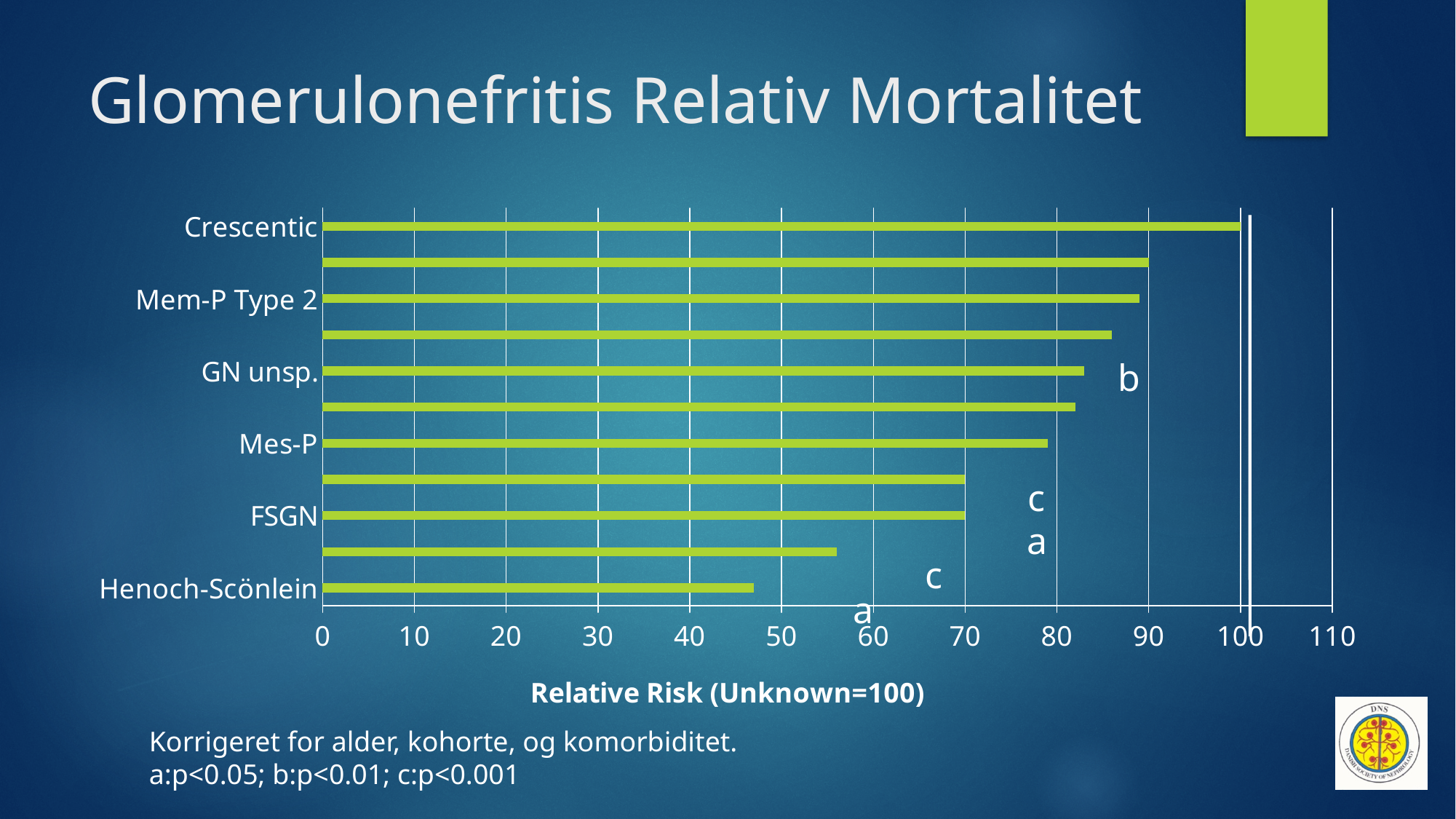
What is the title of the x axis? Relative Risk (Unknown=100) Is the value for Mes-P greater or less than 70? greater What kind of chart is shown on the slide? bar chart Is the value for Henoch-Scönlein greater or less than 50? less Is the value for Crescentic greater or less than 90? greater Which has the larger relative risk, Mem-P Type 2 or Mes-P? Mem-P Type 2 Which labelled category has the lowest relative risk? Henoch-Scönlein How many bars are plotted in the chart? 11 Which labelled category has the highest relative risk? Crescentic